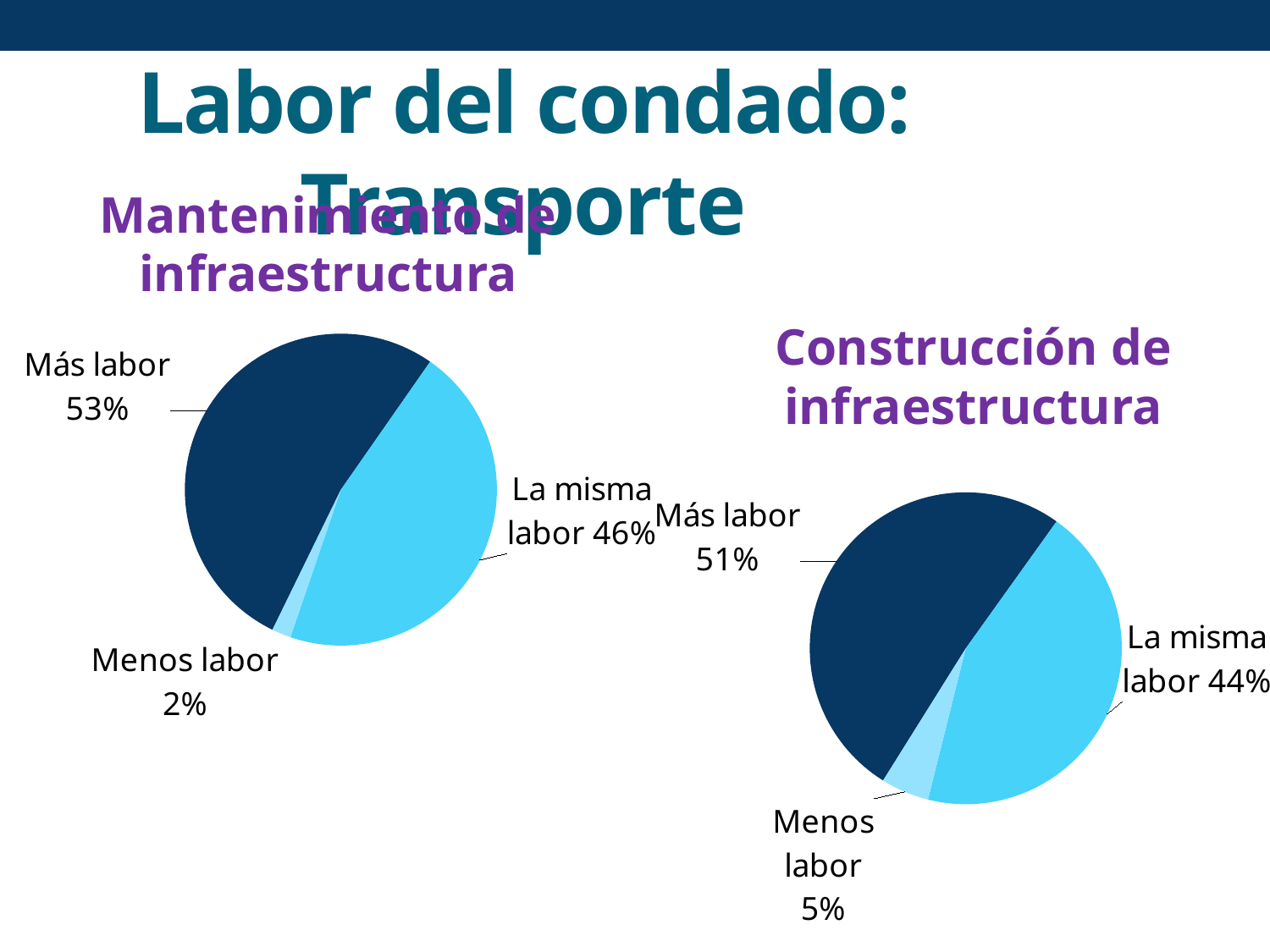
In the Construcción de infraestructura pie chart, what percentage is labelled Más labor? 51% In the Construcción de infraestructura pie chart, what percentage is labelled Menos labor? 5% Which chart has the larger share for Menos labor, Mantenimiento de infraestructura or Construcción de infraestructura? Construcción de infraestructura In the Mantenimiento de infraestructura pie chart, what percentage is labelled Menos labor? 2% In the Construcción de infraestructura pie chart, which category has the smallest share? Menos labor In the Mantenimiento de infraestructura pie chart, what percentage is labelled Más labor? 53% In the Mantenimiento de infraestructura pie chart, which category has the largest share? Más labor How many slices does the Mantenimiento de infraestructura pie chart have? 3 In the Construcción de infraestructura pie chart, what is the difference in percentage points between Más labor and La misma labor? 7 In the Mantenimiento de infraestructura pie chart, what percentage is labelled La misma labor? 46% What type of chart is used for Construcción de infraestructura? Pie chart In the Construcción de infraestructura pie chart, what percentage is labelled La misma labor? 44%